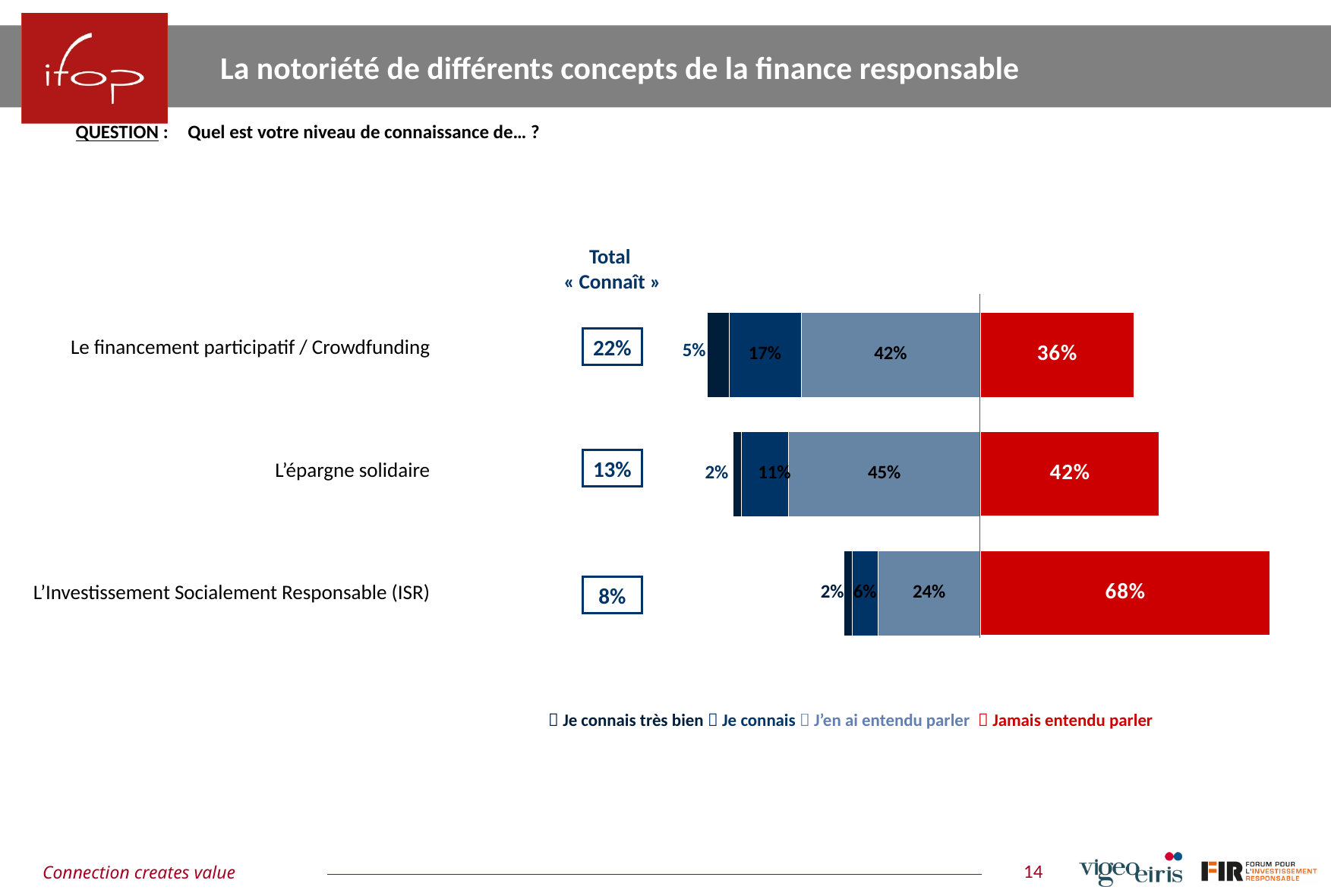
What is the Total « Connaît » value for L'épargne solidaire? 13% Which legend entry is shown in red? Jamais entendu parler What is the 'J'en ai entendu parler' value for L'épargne solidaire? 45% How many series does the legend list? 4 How many categories (concepts) are plotted in the chart? 3 What is the difference between the 'Jamais entendu parler' values for L'épargne solidaire and Le financement participatif / Crowdfunding? 6% Which is larger: the 'Je connais très bien' value for Le financement participatif / Crowdfunding or for L'épargne solidaire? Le financement participatif / Crowdfunding What is the 'Jamais entendu parler' value for L'Investissement Socialement Responsable (ISR)? 68% What kind of chart is shown on the slide? stacked bar chart Which concept has the lowest Total « Connaît » value? L'Investissement Socialement Responsable (ISR) What is the 'Je connais' value for Le financement participatif / Crowdfunding? 17% Which concept has the highest 'Jamais entendu parler' value? L'Investissement Socialement Responsable (ISR)